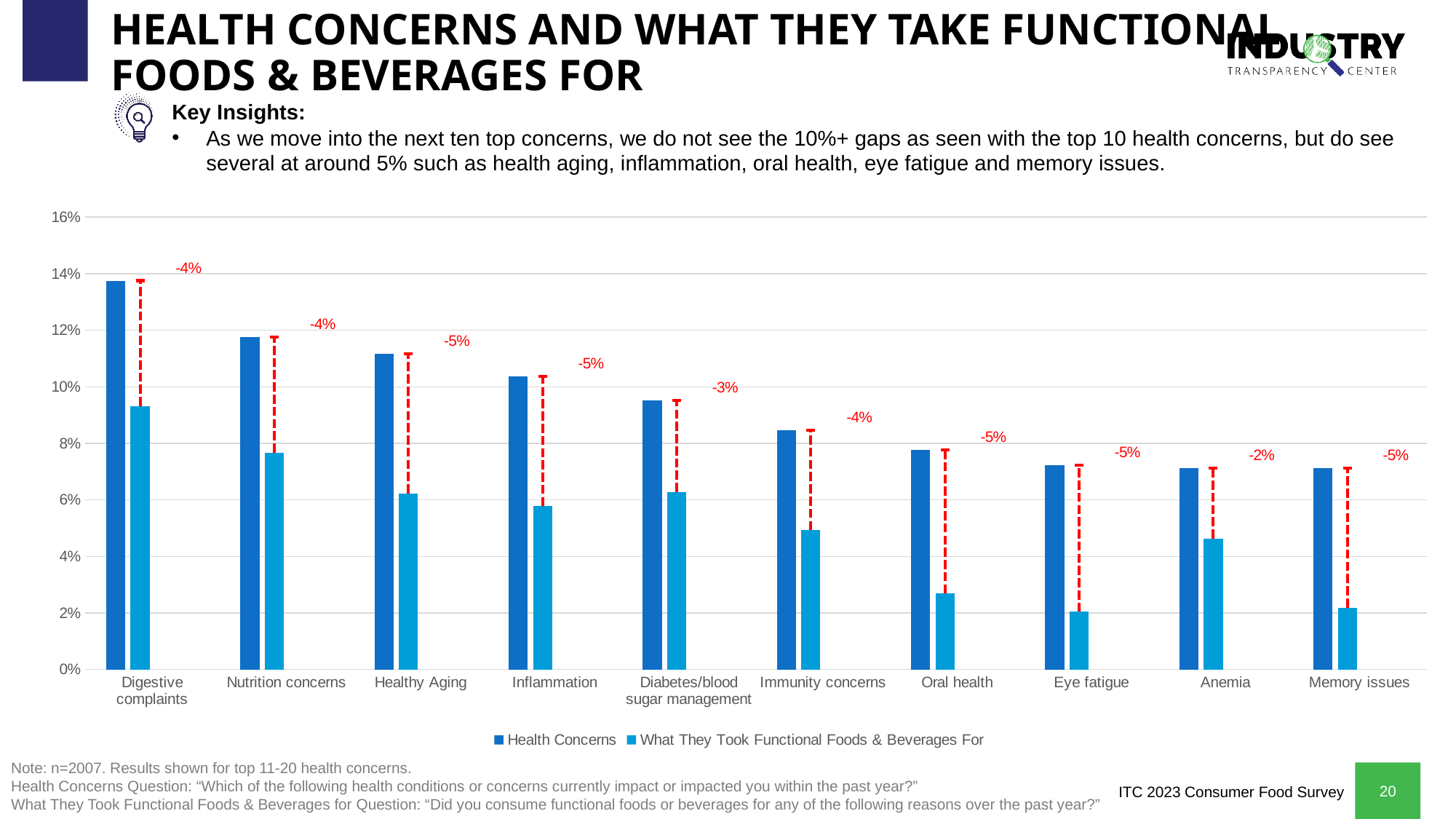
How many health concern categories are shown on the x axis? 10 Which category has the highest Health Concerns value? Digestive complaints What are the two entries in the chart legend? Health Concerns; What They Took Functional Foods & Beverages For What gap label is printed above the Anemia bars? -2% Is the What They Took Functional Foods & Beverages For value for Oral health greater or less than 4%? less Is the Health Concerns value for Digestive complaints greater or less than 12%? greater Do the Health Concerns values rise or fall moving from left to right along the x axis? fall How many series does the chart legend list? 2 Which is larger: the Health Concerns value for Healthy Aging or for Inflammation? Healthy Aging What gap label is printed above the Diabetes/blood sugar management bars? -3% What kind of chart is shown on the slide? bar chart Which category has the highest value for What They Took Functional Foods & Beverages For? Digestive complaints